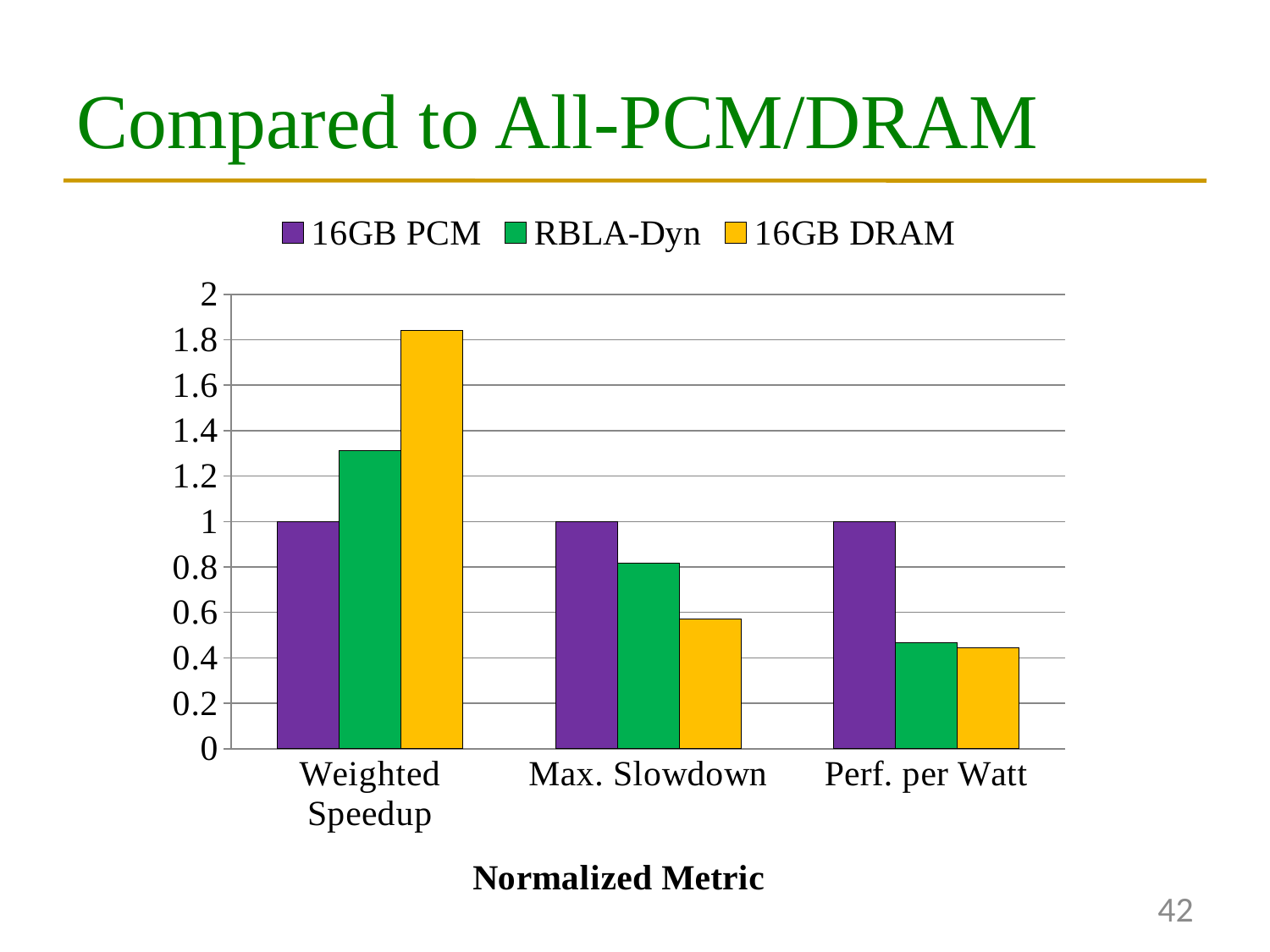
What is the label of the x axis? Normalized Metric What is the value for 16GB PCM in the Weighted Speedup category? 1 Is the value for 16GB DRAM in the Weighted Speedup category greater or less than 1.8? greater How many categories are shown on the x axis? 3 What kind of chart is shown on the slide? bar chart In the Weighted Speedup category, which is larger: the value for RBLA-Dyn or the value for 16GB PCM? RBLA-Dyn How many series does the legend list? 3 Which series has the highest value in the Perf. per Watt category? 16GB PCM Which series has the lowest value in the Max. Slowdown category? 16GB DRAM What is the value for 16GB PCM in the Perf. per Watt category? 1 Which series has the highest value in the Weighted Speedup category? 16GB DRAM